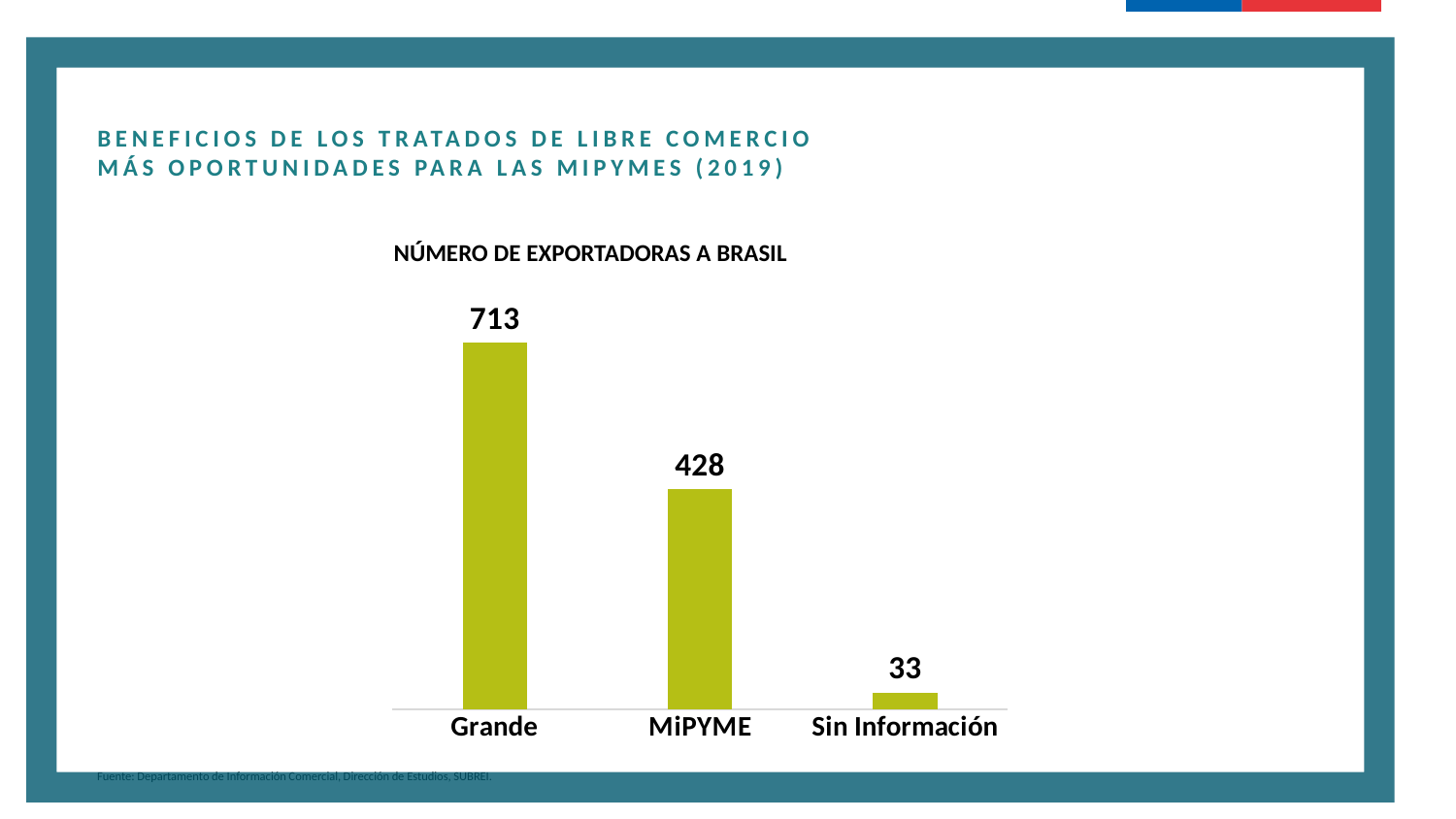
Which is larger, the value for Grande or the value for MiPYME? Grande Which category has the lowest value? Sin Información What is the title of the chart? NÚMERO DE EXPORTADORAS A BRASIL What is the value for MiPYME? 428 What is the value for Sin Información? 33 What is the difference between the values for Grande and MiPYME? 285 Do the values rise or fall from left to right across the categories? Fall What kind of chart is shown on the slide? Bar chart Which category has the highest value? Grande What is the difference between the values for MiPYME and Sin Información? 395 What is the value for Grande? 713 How many categories are shown in the chart? 3